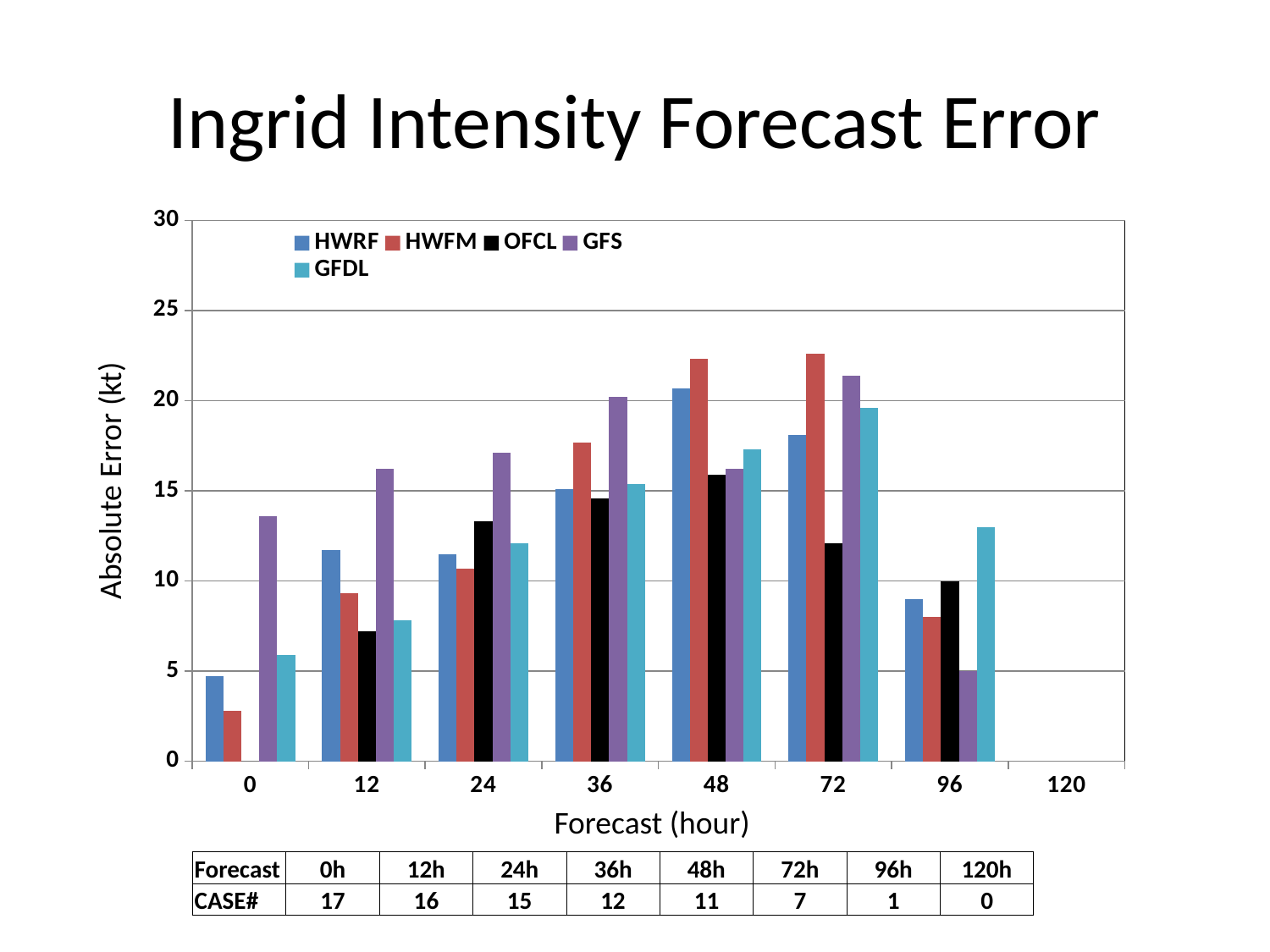
At forecast hour 96, which series has the lowest absolute error? GFS How many forecast hour categories are shown on the x axis? 8 How many series does the legend list? 5 What is the label on the y axis? Absolute Error (kt) Is the HWFM value at forecast hour 48 greater or less than 20? greater What kind of chart is shown on the slide? bar chart Is the GFDL value at forecast hour 96 greater or less than 10? greater At forecast hour 24, which is larger, the GFS value or the OFCL value? GFS At forecast hour 36, which series has the highest absolute error? GFS What is the title of the chart? Ingrid Intensity Forecast Error Is the GFS value at forecast hour 0 greater or less than 10? greater